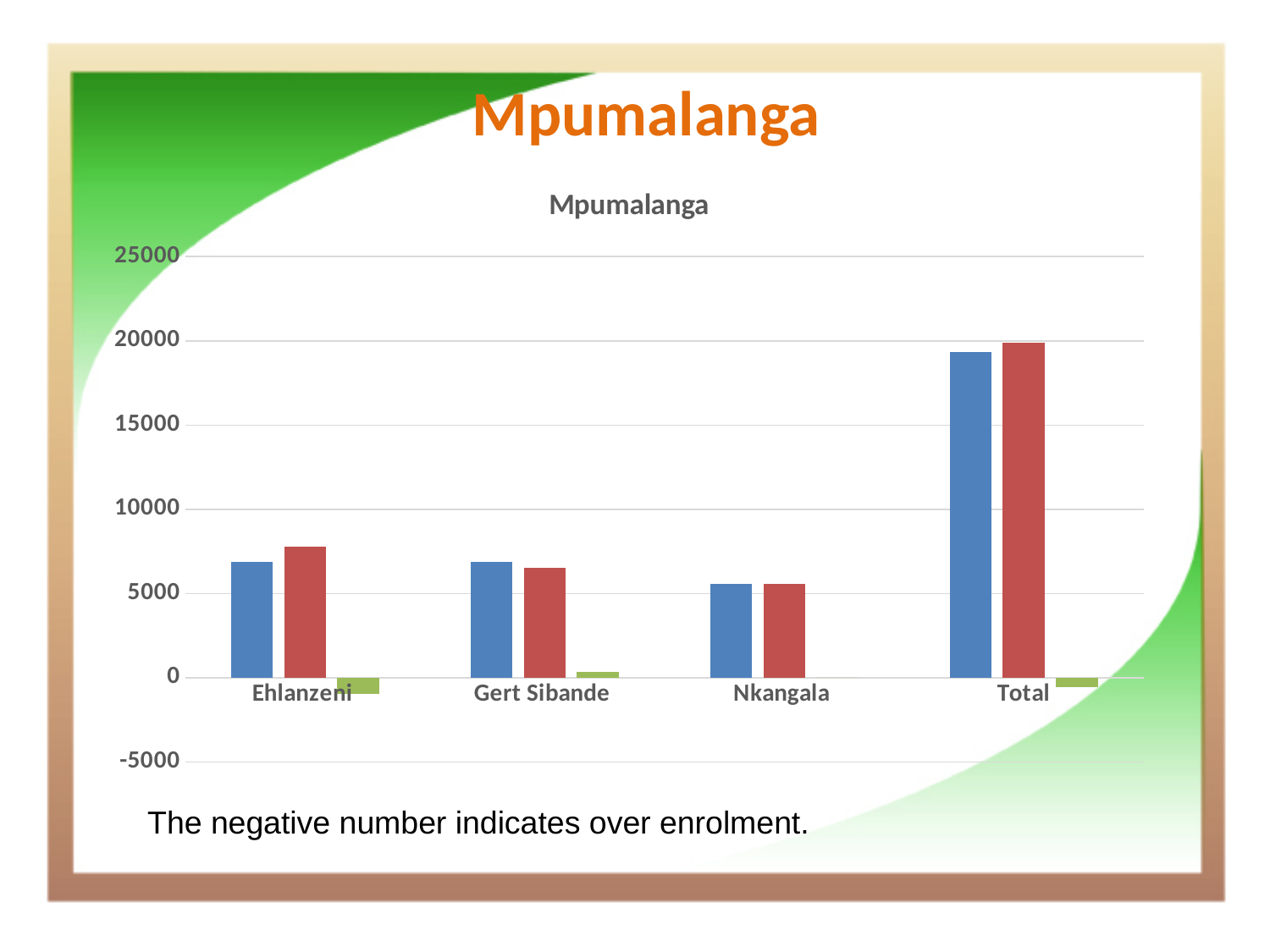
What is the title of the chart? Mpumalanga What kind of chart is shown on the slide? bar chart For Ehlanzeni, which is larger, the blue bar or the red bar? the red bar Which category has the tallest blue bar? Total Is the value of the red bar for Ehlanzeni greater or less than 5000? greater For Gert Sibande, which is larger, the blue bar or the red bar? the blue bar Which category has the shortest red bar? Nkangala Is the value of the blue bar for Total greater or less than 15000? greater Is the value of the green bar for Ehlanzeni greater or less than 0? less According to the note below the chart, what does a negative number indicate? over enrolment How many categories are shown on the x axis of the chart? 4